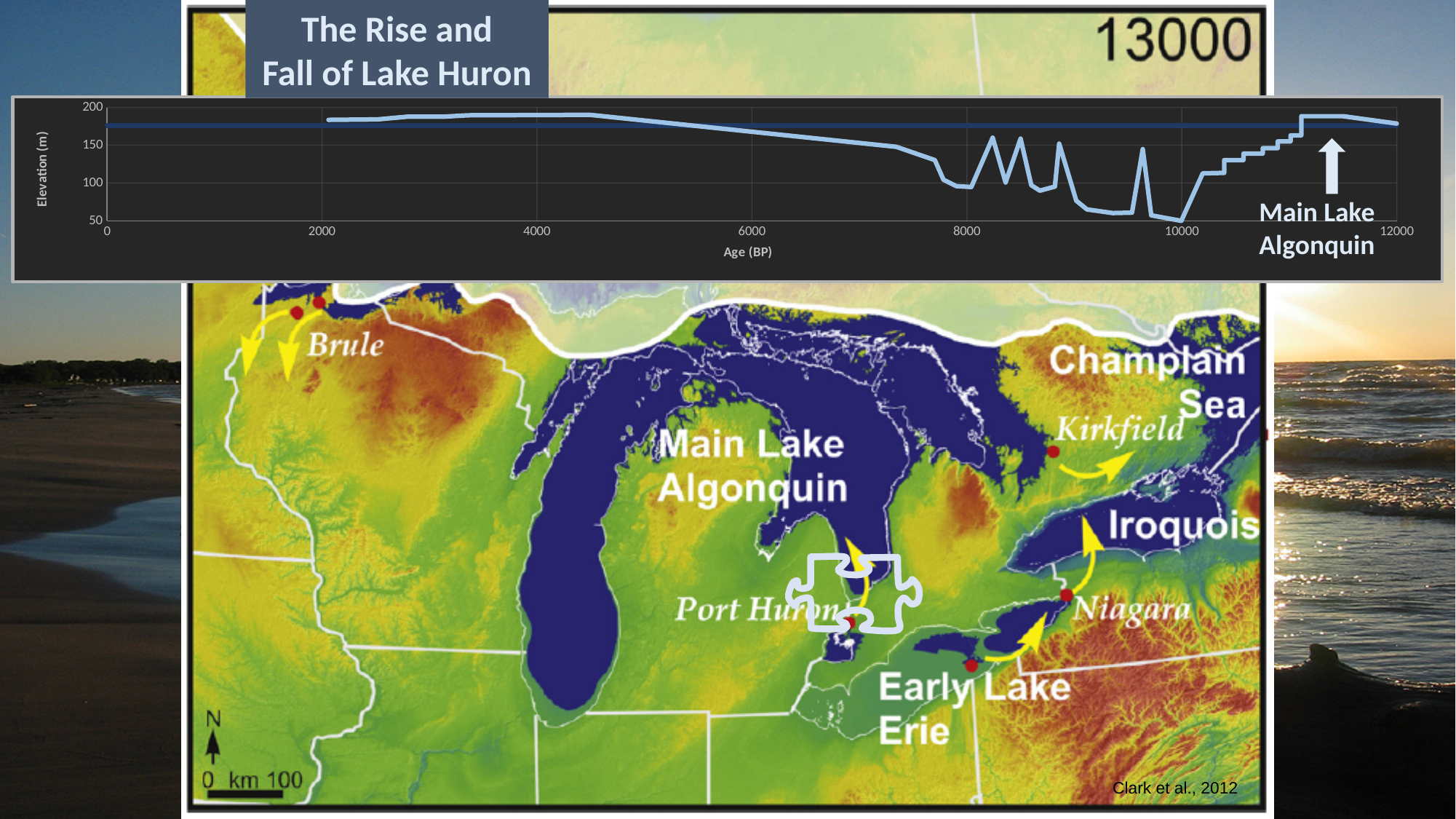
What is the label of the y axis of the chart? Elevation (m) What is the label of the x axis of the chart? Age (BP) Is the elevation at 4000 BP greater or less than 150? greater Does the elevation rise or fall along the x axis between 10000 BP and 11500 BP? rise Which is higher, the elevation at 4000 BP or at 10000 BP? 4000 BP Is the elevation at 10000 BP greater or less than 100? less What is the highest value shown on the x axis of the chart? 12000 Does the elevation rise or fall along the x axis between 4500 BP and 7500 BP? fall Is the elevation at 12000 BP greater or less than 150? greater What kind of chart is shown at the top of the slide? line chart